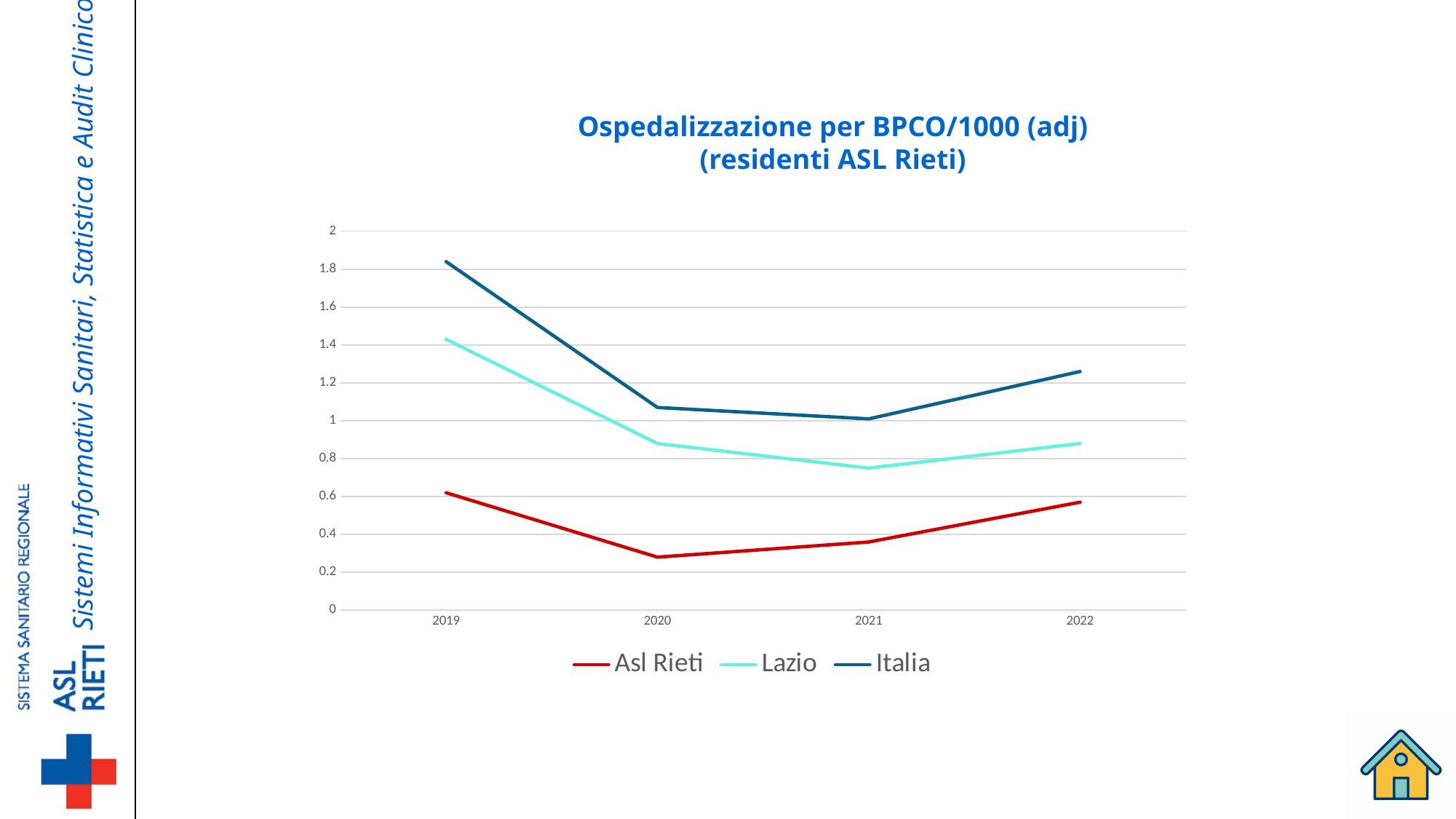
What kind of chart is shown on the slide? line chart In 2020, which is larger: the value for Italia or the value for Lazio? Italia Is the value for Lazio in 2019 greater or less than 1.2? greater In which year is the Asl Rieti line at its lowest? 2020 How many years are shown on the x axis? 4 In which year is the Lazio line at its lowest? 2021 Which series is drawn in red? Asl Rieti Does the Asl Rieti line rise or fall from 2019 to 2020? fall In which year is the Italia line at its highest? 2019 How many series does the legend list? 3 Is the value for Italia in 2019 greater or less than 1.6? greater Is the value for Asl Rieti in 2020 greater or less than 0.4? less